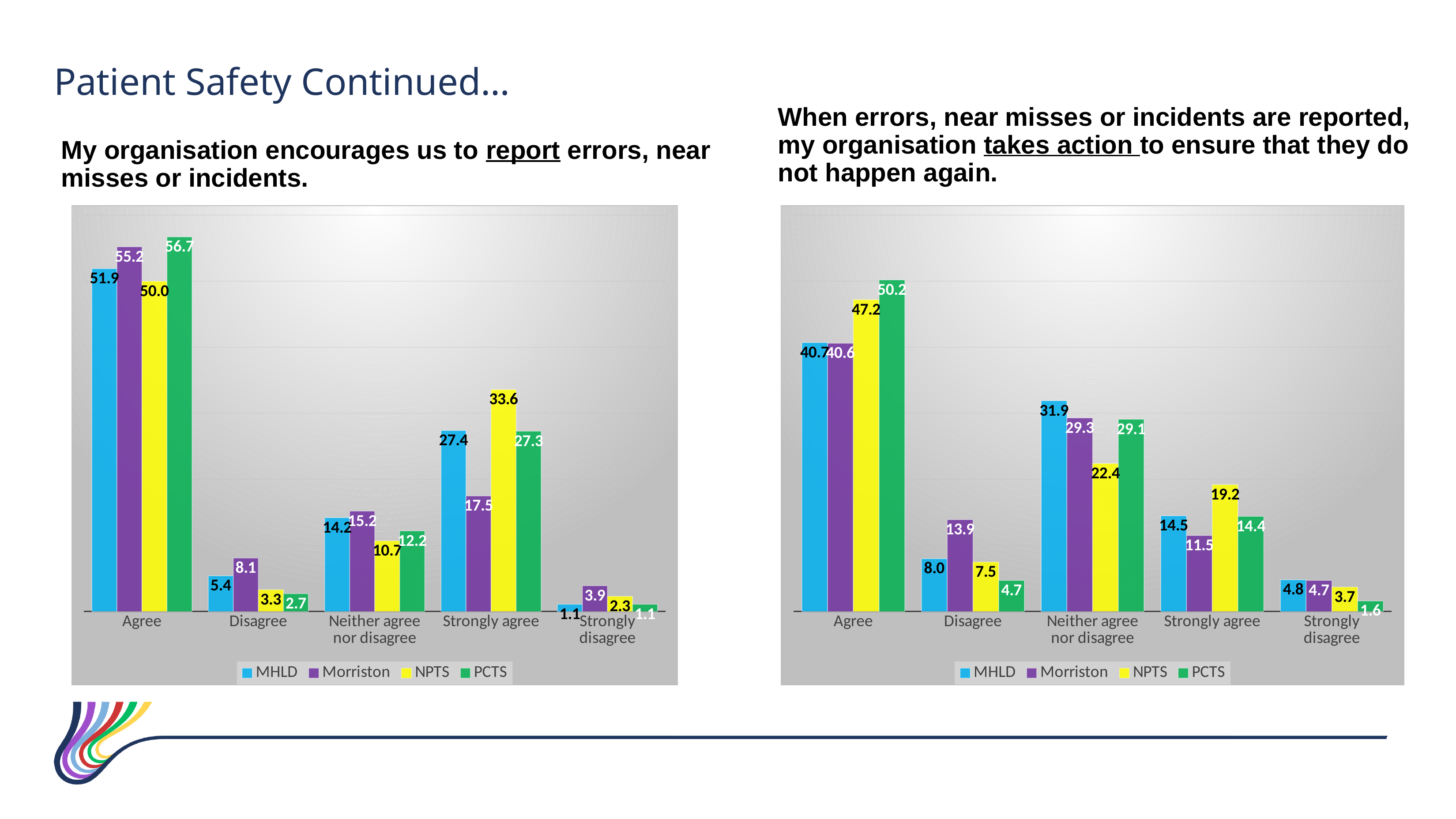
In the left chart ("My organisation encourages us to report errors, near misses or incidents"), what is the difference between the Morriston and MHLD values in the Agree category? 3.3 In the left chart ("My organisation encourages us to report errors, near misses or incidents"), which series has the highest value in the Agree category? PCTS In the right chart ("When errors, near misses or incidents are reported, my organisation takes action..."), which series has the highest value in the Neither agree nor disagree category? MHLD In the right chart ("When errors, near misses or incidents are reported, my organisation takes action..."), what is the difference between the PCTS and MHLD values in the Agree category? 9.5 In the right chart ("When errors, near misses or incidents are reported, my organisation takes action..."), what is the value for Morriston in the Disagree category? 13.9 How many categories are shown on the x axis of the right chart? 5 How many series does the legend of the left chart list? 4 In the left chart ("My organisation encourages us to report errors, near misses or incidents"), what is the value for NPTS in the Strongly agree category? 33.6 In the left chart ("My organisation encourages us to report errors, near misses or incidents"), what is the value for PCTS in the Agree category? 56.7 In the right chart ("When errors, near misses or incidents are reported, my organisation takes action..."), what is the value for NPTS in the Agree category? 47.2 In the left chart ("My organisation encourages us to report errors, near misses or incidents"), which series has the lowest value in the Disagree category? PCTS In the right chart ("When errors, near misses or incidents are reported, my organisation takes action..."), which is larger in the Strongly agree category: NPTS or PCTS? NPTS